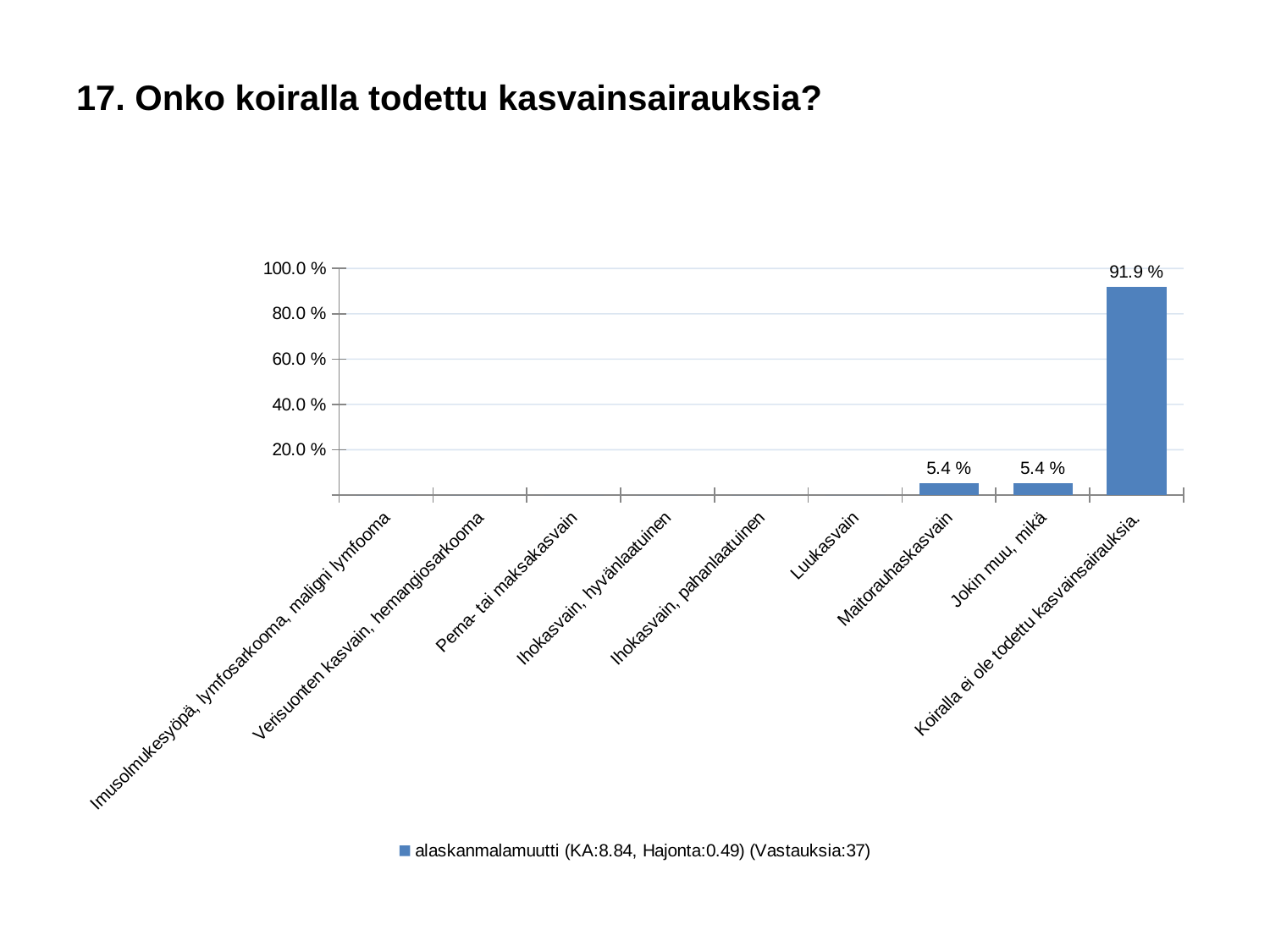
What is the title of the slide? 17. Onko koiralla todettu kasvainsairauksia? How many series does the legend list? 1 What is the value for "Jokin muu, mikä"? 5.4 % Which category has the highest value? Koiralla ei ole todettu kasvainsairauksia. What is the value for "Maitorauhaskasvain"? 5.4 % What is the difference between the values for "Koiralla ei ole todettu kasvainsairauksia." and "Maitorauhaskasvain"? 86.5 % Is the value for "Koiralla ei ole todettu kasvainsairauksia." greater or less than 80.0 %? greater What is the value for "Koiralla ei ole todettu kasvainsairauksia."? 91.9 % Is the value for "Maitorauhaskasvain" greater or less than 20.0 %? less What kind of chart is shown on the slide? bar chart How many categories are shown on the x axis? 9 Which is larger, the value for "Koiralla ei ole todettu kasvainsairauksia." or the value for "Jokin muu, mikä"? Koiralla ei ole todettu kasvainsairauksia.